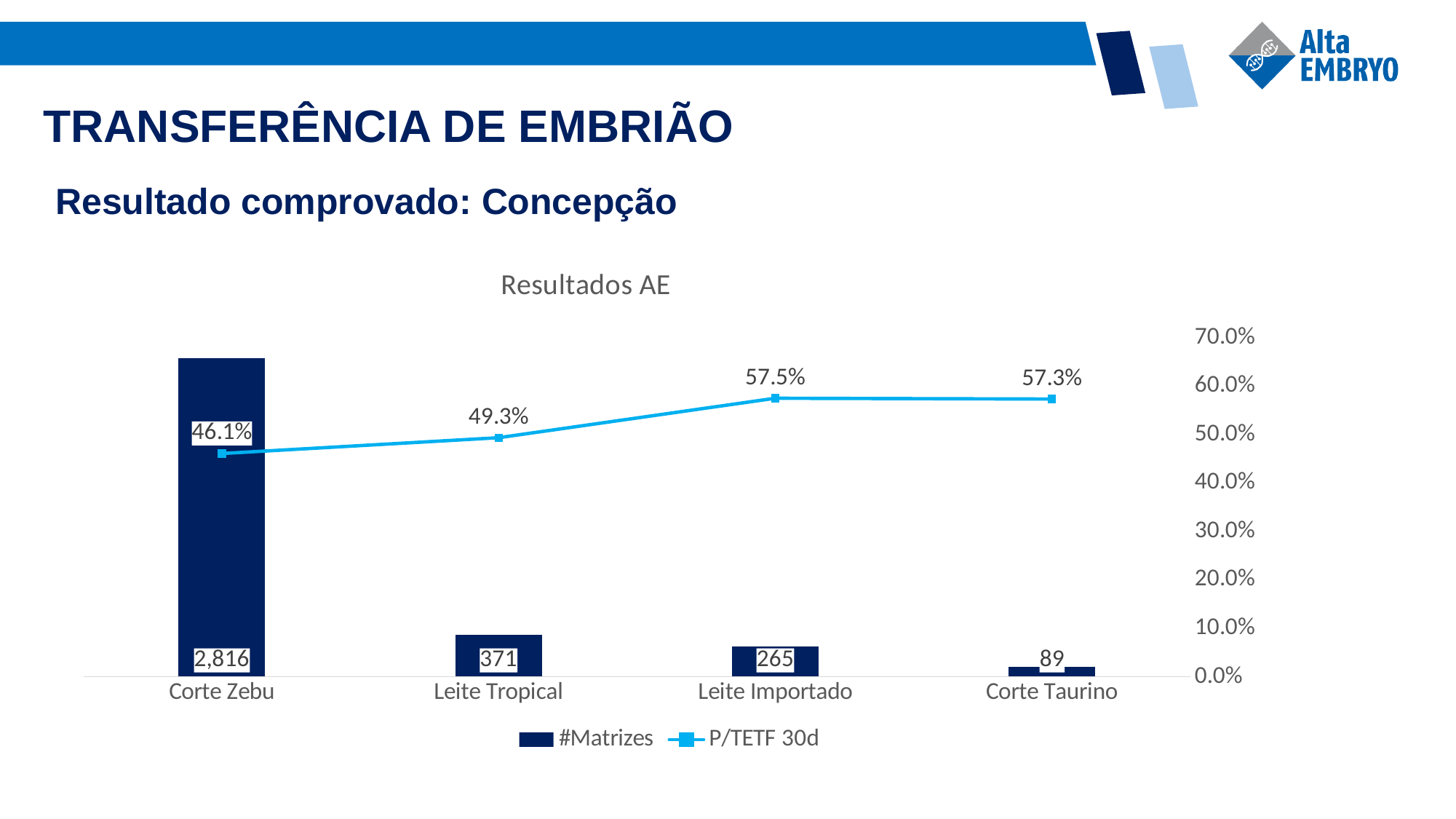
What is the P/TETF 30d value for Leite Importado? 57.5% How many series does the legend list? 2 What is the P/TETF 30d value for Leite Tropical? 49.3% What is the difference in #Matrizes between Leite Tropical and Leite Importado? 106 Which has a higher P/TETF 30d value, Corte Zebu or Leite Tropical? Leite Tropical What is the #Matrizes value for Corte Taurino? 89 Which category has the lowest P/TETF 30d value? Corte Zebu What kind of chart is this? Combined bar and line chart Which category has the highest #Matrizes value? Corte Zebu How many categories are shown on the x axis? 4 What is the #Matrizes value for Corte Zebu? 2,816 What is the title of the chart? Resultados AE